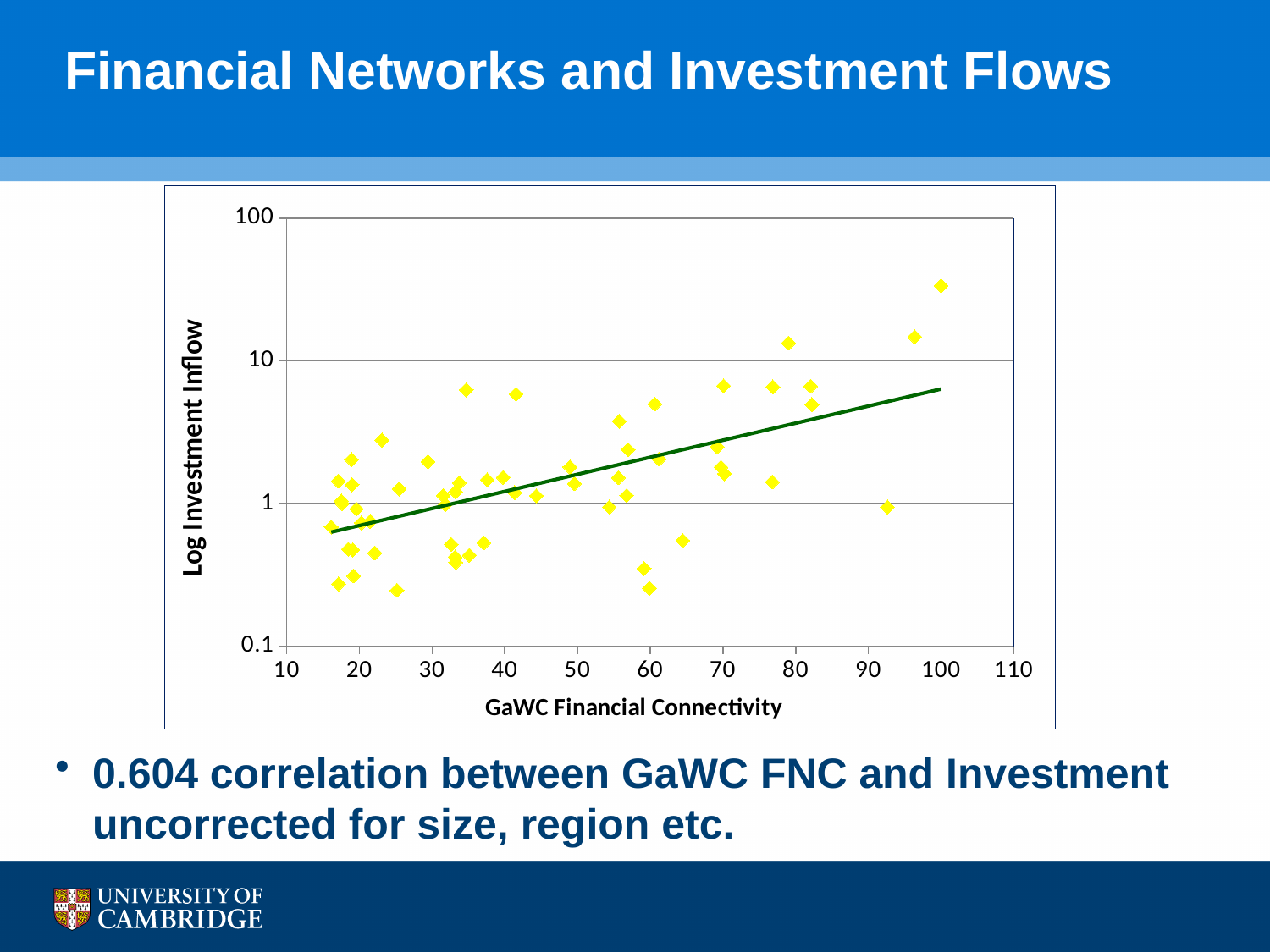
Is the investment inflow of the lowest point in the chart greater or less than 1? less What is the title of the y axis of the chart? Log Investment Inflow Is the value of the trend line at a GaWC Financial Connectivity of 100 greater or less than 10? less Does the trend line in the chart rise or fall as GaWC Financial Connectivity increases? Rises Is the investment inflow of the rightmost point (at a connectivity of about 100) greater or less than 10? greater What is the title of the x axis of the chart? GaWC Financial Connectivity Which has the higher investment inflow: the rightmost point or the second-rightmost point in the chart? The rightmost point What kind of chart is shown on the slide? Scatter chart